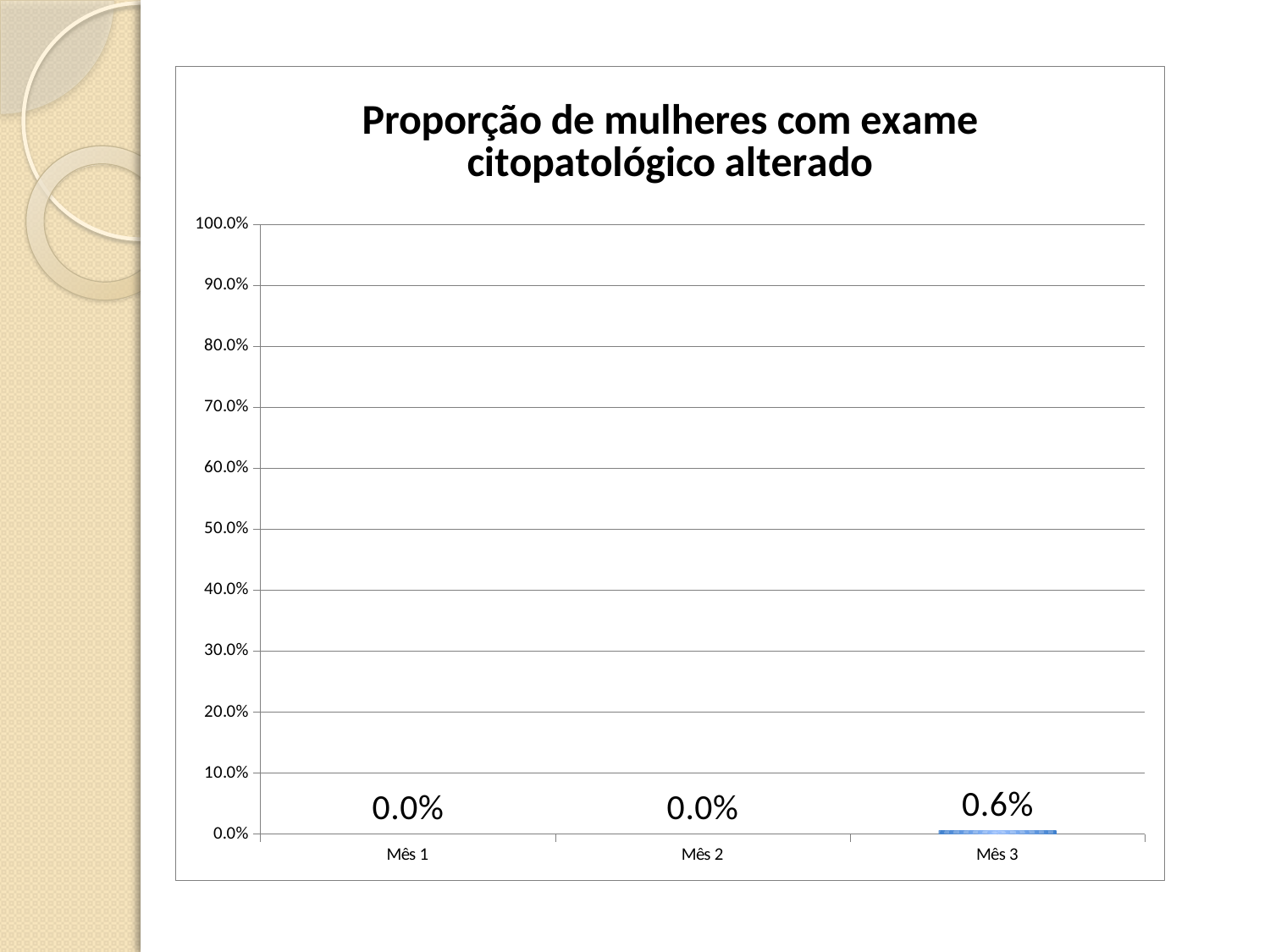
What is the difference between the values for Mês 3 and Mês 2? 0.6% Is the value for Mês 3 greater or less than 10.0%? less What is the value for Mês 2? 0.0% Do the values rise or fall from Mês 2 to Mês 3? rise What is the highest value shown on the y axis? 100.0% What kind of chart is shown on the slide? bar chart How many categories are shown on the x axis? 3 What is the value for Mês 1? 0.0% Which is larger, the value for Mês 3 or the value for Mês 1? Mês 3 What is the title of the chart? Proporção de mulheres com exame citopatológico alterado What is the value for Mês 3? 0.6% Which month has the highest value? Mês 3